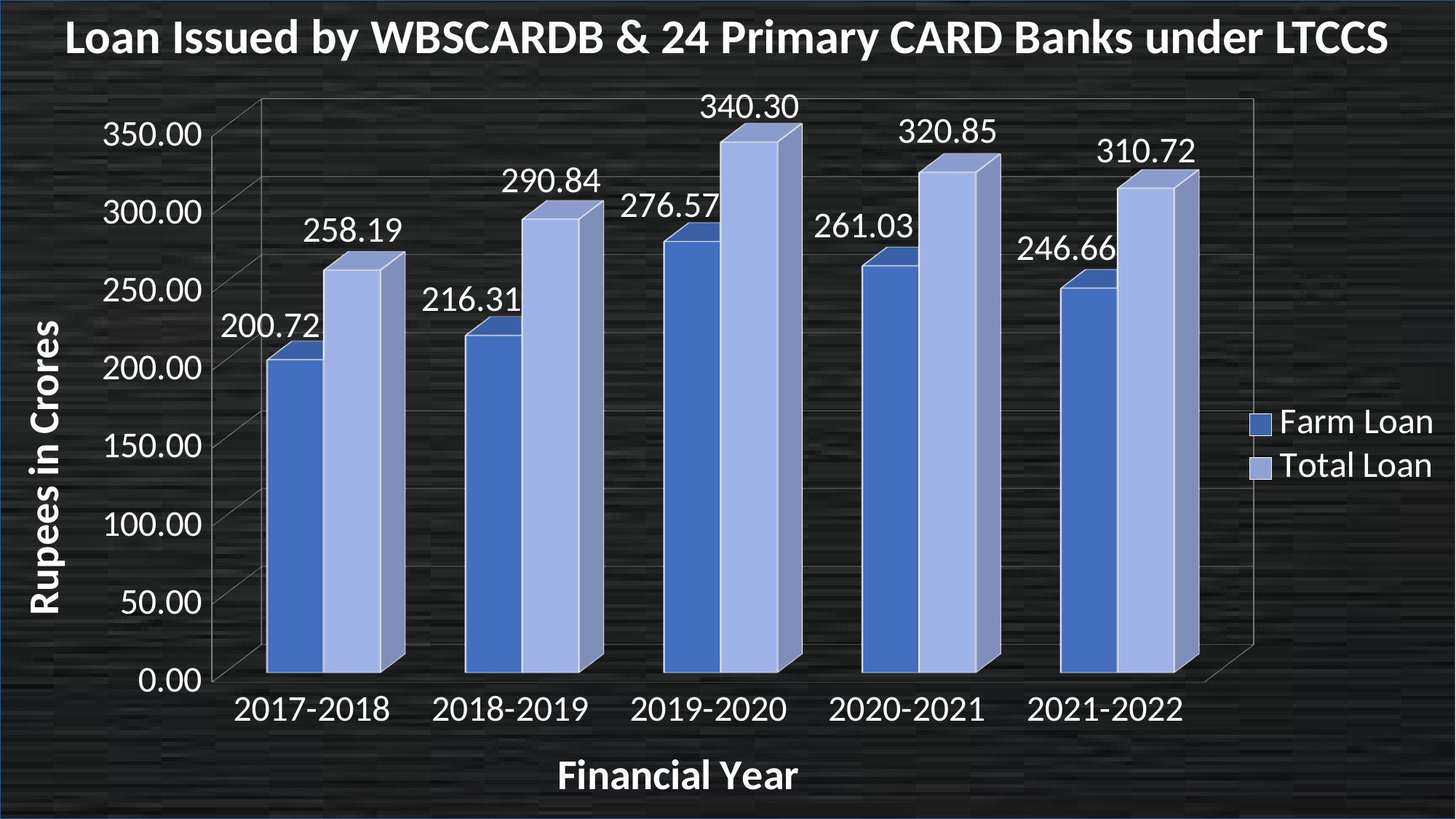
Which is larger: the Total Loan for 2020-2021 or the Total Loan for 2021-2022? 2020-2021 What is the Total Loan value for 2021-2022? 310.72 Which financial year has the highest Total Loan? 2019-2020 What is the label of the y axis? Rupees in Crores How many financial years are shown on the x axis? 5 What is the difference between Total Loan and Farm Loan in 2018-2019? 74.53 What is the Farm Loan value for 2017-2018? 200.72 Does the Farm Loan rise or fall from 2017-2018 to 2019-2020? Rise How many series does the legend list? 2 What kind of chart is shown on the slide? Bar chart Which financial year has the lowest Farm Loan? 2017-2018 What is the Farm Loan value for 2019-2020? 276.57